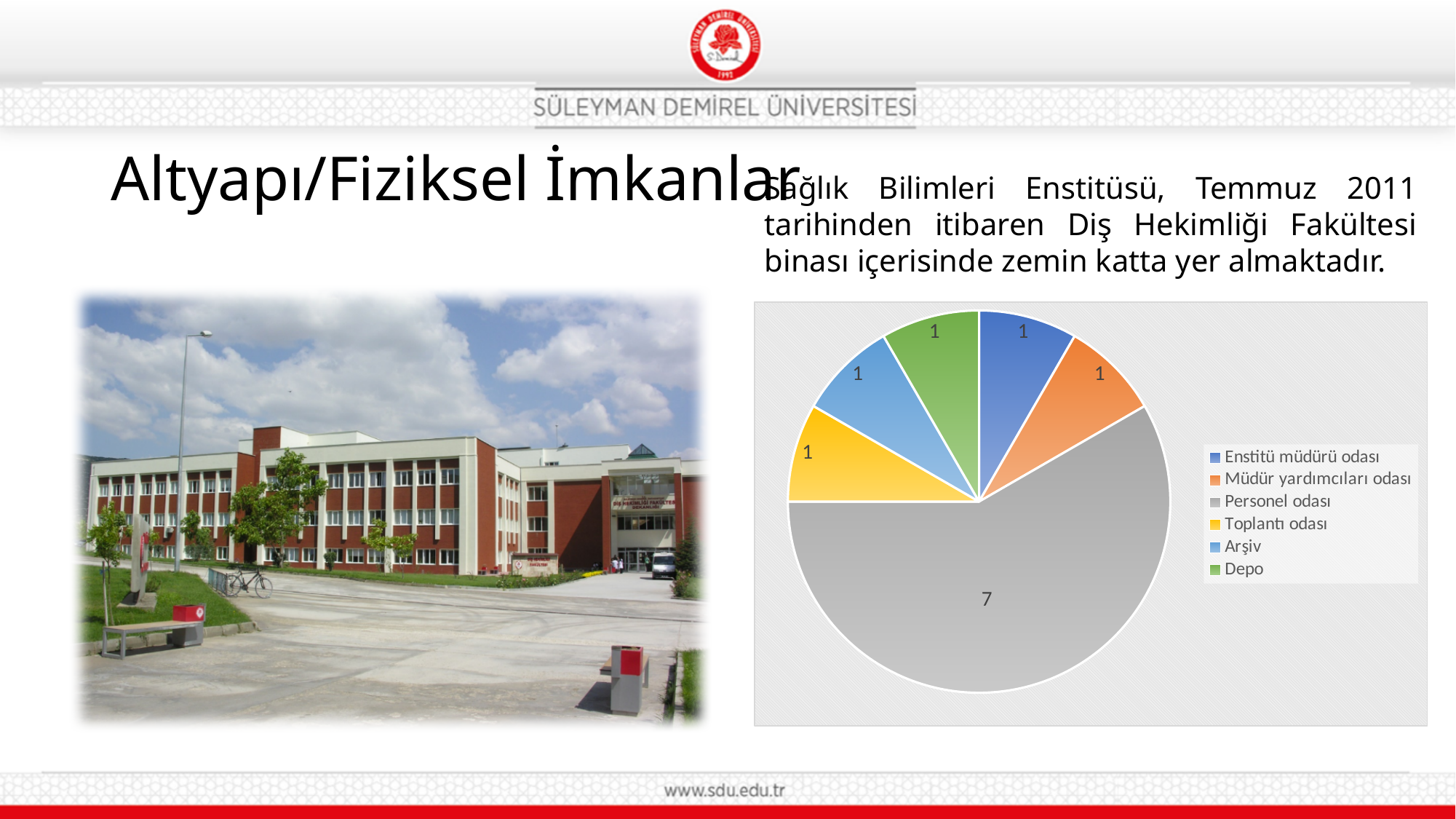
What colour is the Personel odası slice in the pie chart? grey How many entries does the legend of the pie chart list? 6 What is the total of all the values shown in the pie chart? 12 What is the value for Personel odası in the pie chart? 7 What is the difference between the values for Personel odası and Arşiv? 6 What is the value for Depo in the pie chart? 1 What is the value for Toplantı odası in the pie chart? 1 Which is larger, the value for Personel odası or the value for Müdür yardımcıları odası? Personel odası Which legend entry is listed first in the pie chart's legend? Enstitü müdürü odası How many categories does the pie chart have? 6 What type of chart is shown on the slide? pie chart Which category has the largest slice in the pie chart? Personel odası